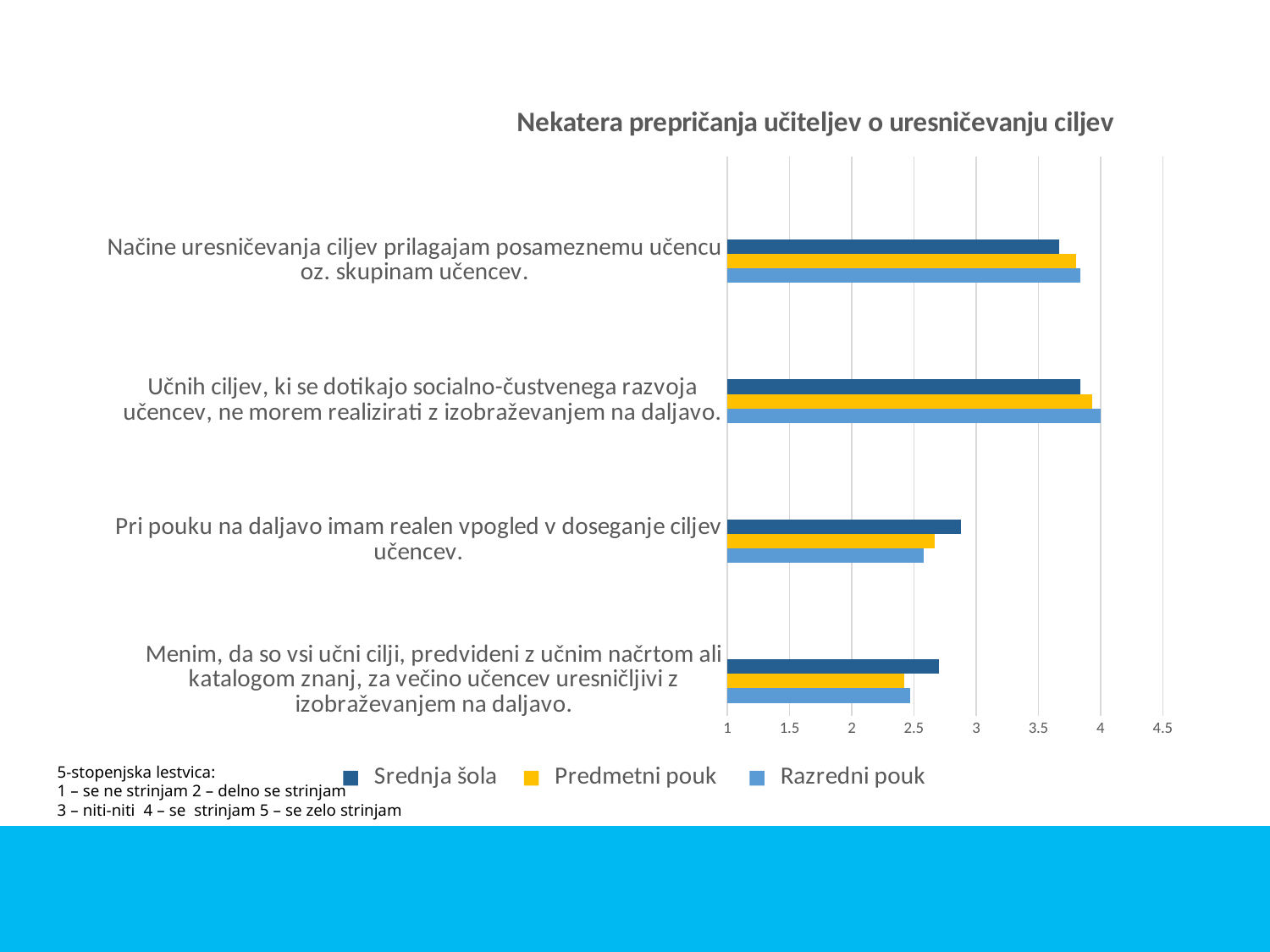
How many series does the legend list? 3 Is the Srednja šola value for 'Učnih ciljev, ki se dotikajo socialno-čustvenega razvoja učencev, ne morem realizirati z izobraževanjem na daljavo.' greater or less than 3.5? greater For which statement is the Razredni pouk value the highest? Učnih ciljev, ki se dotikajo socialno-čustvenega razvoja učencev, ne morem realizirati z izobraževanjem na daljavo. What kind of chart is shown on the slide? bar chart Is the Predmetni pouk value for 'Menim, da so vsi učni cilji, predvideni z učnim načrtom ali katalogom znanj, za večino učencev uresničljivi z izobraževanjem na daljavo.' greater or less than 3? less For the statement 'Pri pouku na daljavo imam realen vpogled v doseganje ciljev učencev.', which is larger: Srednja šola or Razredni pouk? Srednja šola For the statement 'Menim, da so vsi učni cilji, predvideni z učnim načrtom ali katalogom znanj, za večino učencev uresničljivi z izobraževanjem na daljavo.', which is larger: Srednja šola or Predmetni pouk? Srednja šola Is the Razredni pouk value for 'Načine uresničevanja ciljev prilagajam posameznemu učencu oz. skupinam učencev.' greater or less than 3.5? greater For which statement is the Srednja šola value the lowest? Menim, da so vsi učni cilji, predvideni z učnim načrtom ali katalogom znanj, za večino učencev uresničljivi z izobraževanjem na daljavo. What is the title of the chart? Nekatera prepričanja učiteljev o uresničevanju ciljev How many statement categories are plotted on the chart? 4 Which colour represents the series Predmetni pouk? yellow